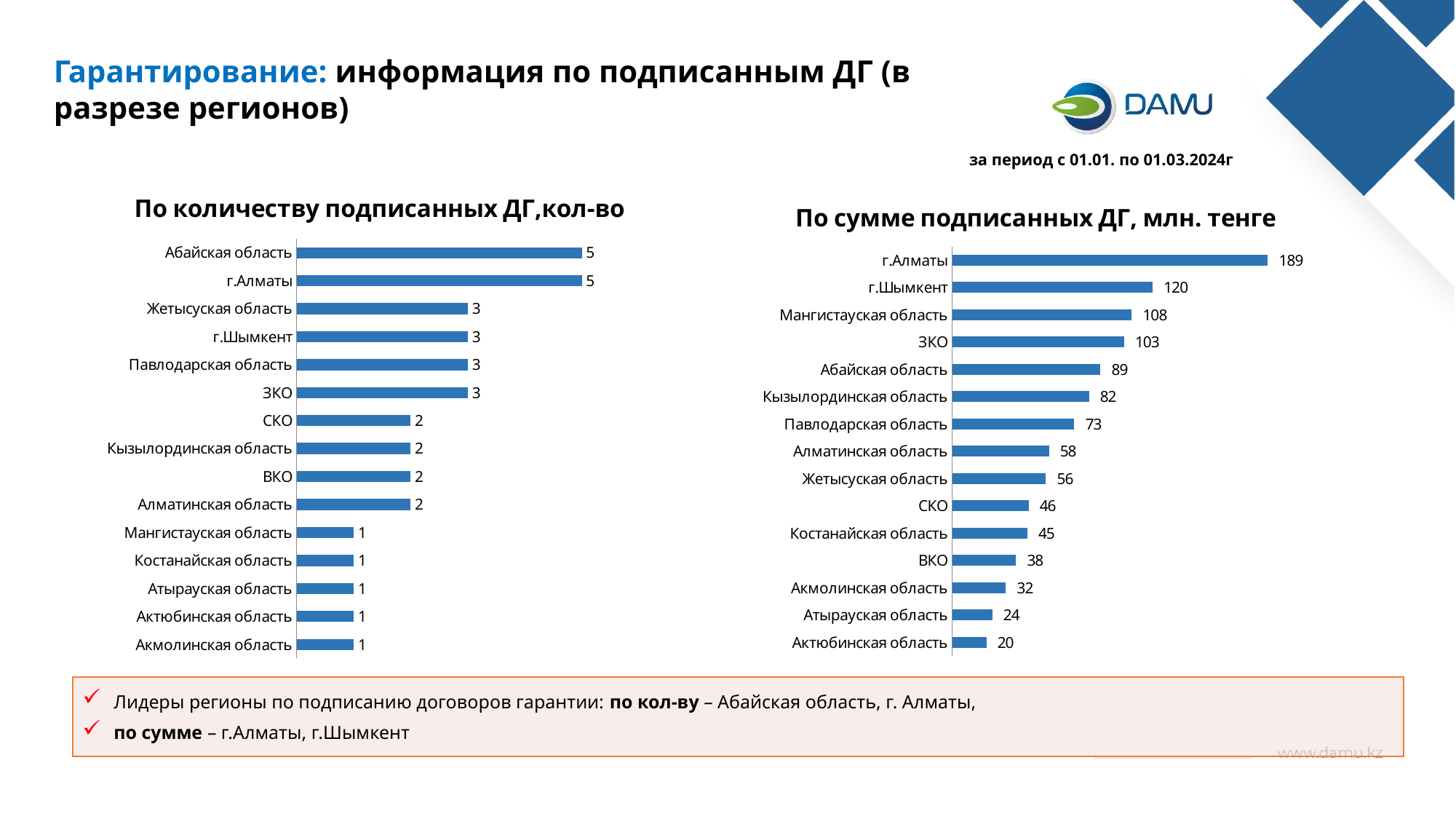
What type of chart is 'По сумме подписанных ДГ, млн. тенге'? Bar chart In the chart 'По сумме подписанных ДГ, млн. тенге', which region has the highest value? г.Алматы In the chart 'По количеству подписанных ДГ,кол-во', which is larger: the value for СКО or the value for Мангистауская область? СКО In the chart 'По количеству подписанных ДГ,кол-во', what is the value for Жетысуская область? 3 How many regions are shown in the chart 'По количеству подписанных ДГ,кол-во'? 15 In the chart 'По сумме подписанных ДГ, млн. тенге', what is the value for Мангистауская область? 108 In the chart 'По сумме подписанных ДГ, млн. тенге', which region has the lowest value? Актюбинская область In the chart 'По сумме подписанных ДГ, млн. тенге', what is the difference between ЗКО and ВКО? 65 In the chart 'По сумме подписанных ДГ, млн. тенге', what is the difference between г.Алматы and г.Шымкент? 69 In the chart 'По сумме подписанных ДГ, млн. тенге', which is larger: the value for Абайская область or the value for Павлодарская область? Абайская область In the chart 'По количеству подписанных ДГ,кол-во', what is the value for Акмолинская область? 1 What period is stated on the slide for the data shown? с 01.01. по 01.03.2024г